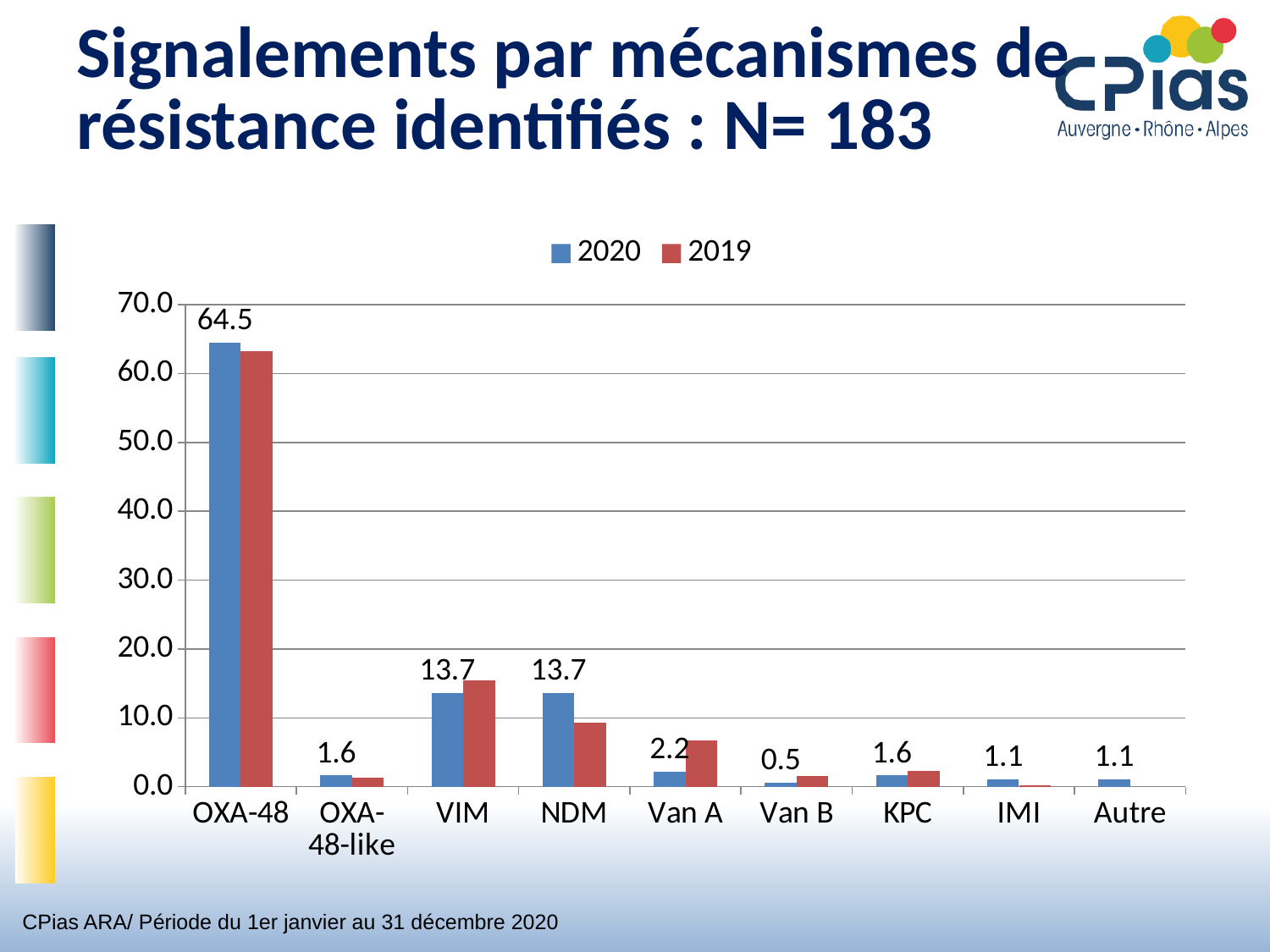
Which category has the lowest 2020 value? Van B Is the 2019 value for VIM greater or less than 10? greater How many categories are shown on the x axis? 9 What kind of chart is shown on the slide? bar chart How many series does the legend list? 2 For Van A, which series has the larger value, 2020 or 2019? 2019 What is the 2020 value for OXA-48? 64.5 What is the difference between the 2020 values for OXA-48 and VIM? 50.8 What is the 2020 value for Van A? 2.2 Which category has the highest 2020 value? OXA-48 What is the 2020 value for Van B? 0.5 Is the 2019 value for OXA-48 greater or less than 60? greater